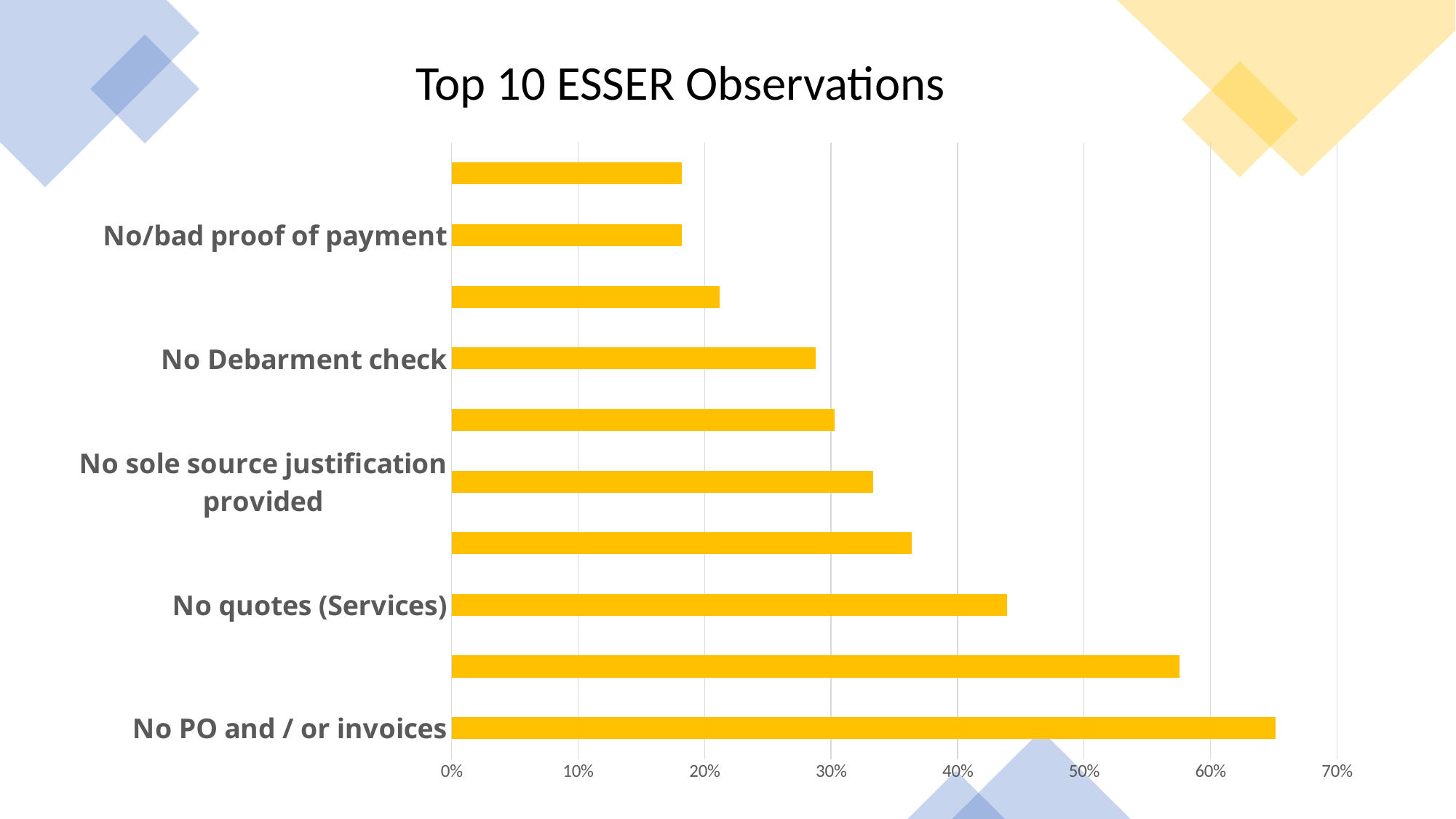
What is the title of the chart? Top 10 ESSER Observations Which is larger, the value for No sole source justification provided or the value for No/bad proof of payment? No sole source justification provided What kind of chart is shown on the slide? bar chart Is the value for No sole source justification provided greater or less than 30%? greater Is the value for No quotes (Services) greater or less than 40%? greater Is the value for No PO and / or invoices greater or less than 60%? greater Which category has the longest bar in the chart? No PO and / or invoices How many bars are plotted in the chart? 10 Which is larger, the value for No quotes (Services) or the value for No Debarment check? No quotes (Services) What is the highest value shown on the horizontal axis? 70%